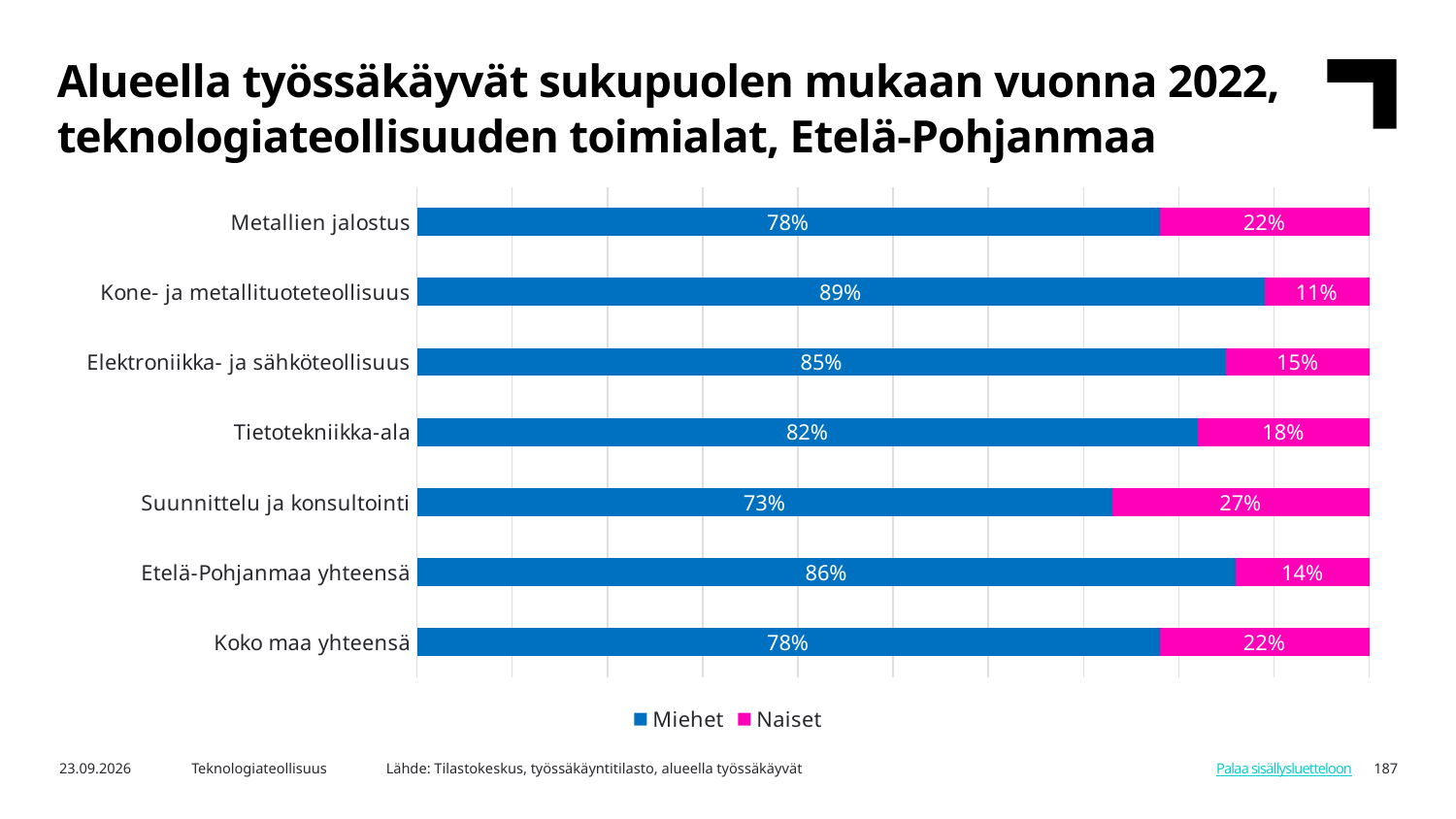
Which category has the lowest Miehet share? Suunnittelu ja konsultointi What is the Miehet share for Tietotekniikka-ala? 82% Which colour represents Naiset in the chart? Pink (magenta) Which is larger: the Naiset share for Elektroniikka- ja sähköteollisuus or for Tietotekniikka-ala? Tietotekniikka-ala How many series does the legend list? 2 What is the difference between the Naiset share for Suunnittelu ja konsultointi and for Kone- ja metallituoteteollisuus? 16 percentage points Which category has the highest Miehet share? Kone- ja metallituoteteollisuus What is the Miehet share for Kone- ja metallituoteteollisuus? 89% What is the Naiset share for Etelä-Pohjanmaa yhteensä? 14% How many categories are shown on the chart? 7 What is the Naiset share for Suunnittelu ja konsultointi? 27% What kind of chart is shown on the slide? Stacked bar chart